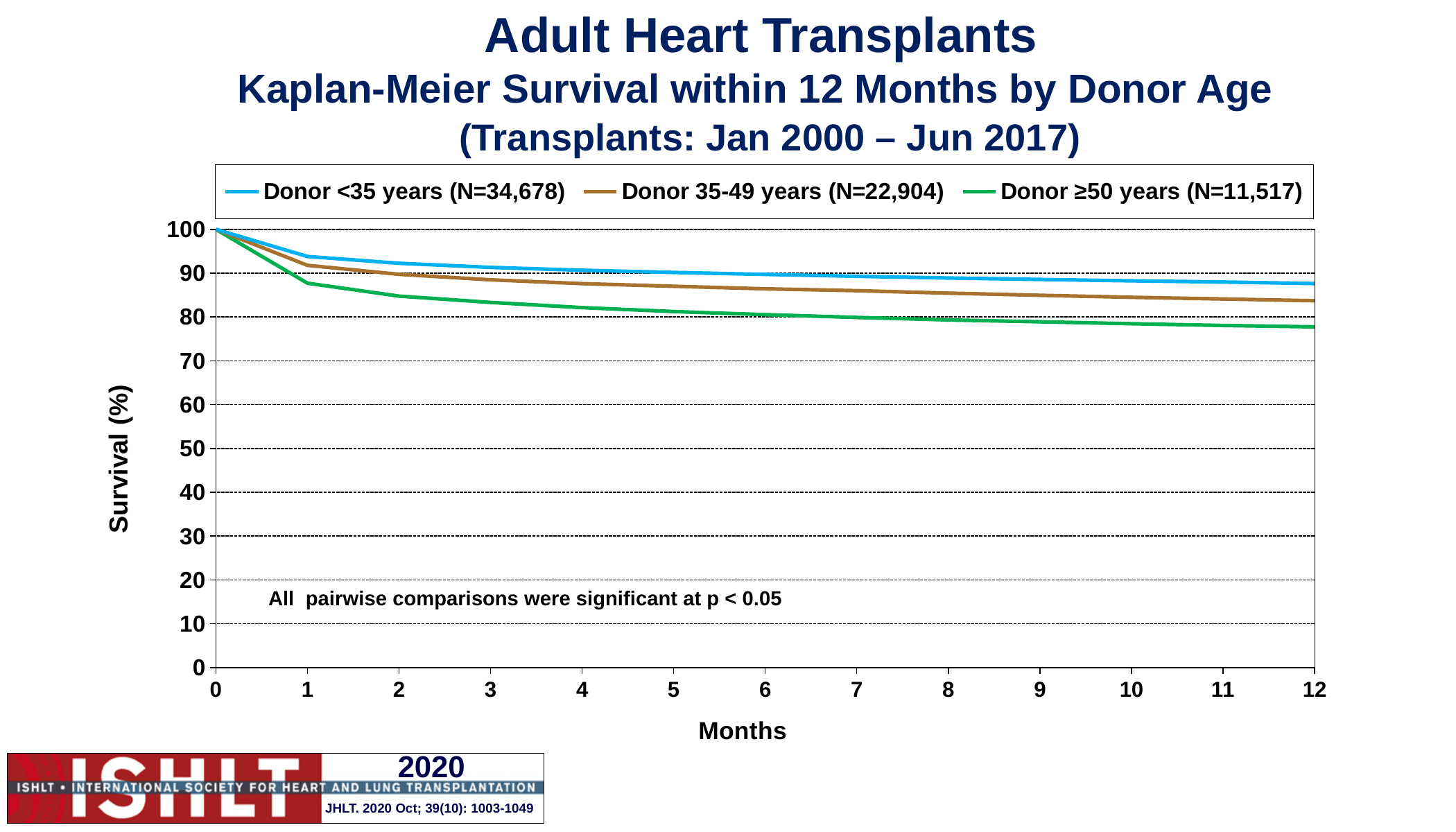
Is the survival value for Donor ≥50 years at month 1 greater or less than 90? less How many series does the legend list? 3 Do the survival curves rise or fall as months increase? fall Is the survival value for Donor <35 years at 12 months greater or less than 80? greater What is the survival value for all three donor age groups at month 0? 100 What is the label of the y axis? Survival (%) At 6 months, which has higher survival: Donor 35-49 years or Donor ≥50 years? Donor 35-49 years Is the survival value for Donor <35 years at month 1 greater or less than 90? greater Which donor age group has the lowest survival at 12 months? Donor ≥50 years (N=11,517) What type of chart is shown on the slide? line chart Which donor age group has the highest survival at 12 months? Donor <35 years (N=34,678)